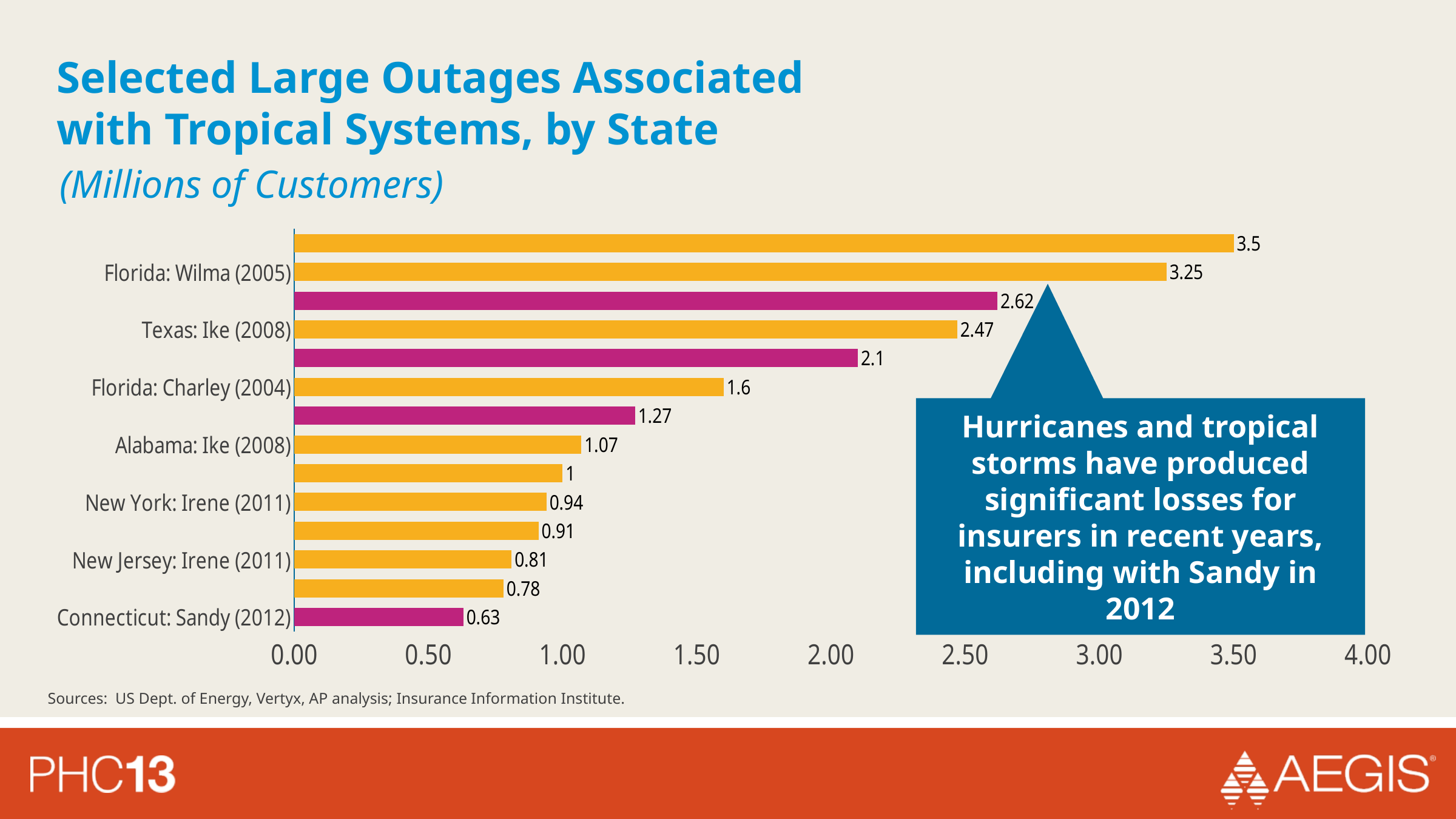
What is the value for Florida: Wilma (2005)? 3.25 What kind of chart is shown on the slide? bar chart Which is larger, the value for Texas: Ike (2008) or Florida: Charley (2004)? Texas: Ike (2008) What is the value for Texas: Ike (2008)? 2.47 What is the difference between the values for Florida: Wilma (2005) and Texas: Ike (2008)? 0.78 What is the largest value shown on any bar in the chart? 3.5 What is the difference between the values for New York: Irene (2011) and New Jersey: Irene (2011)? 0.13 How many bars are plotted in the chart? 14 What is the value for Florida: Charley (2004)? 1.6 What is the value for Connecticut: Sandy (2012)? 0.63 Which labeled category has the lowest value? Connecticut: Sandy (2012) Is the value for Alabama: Ike (2008) greater or less than 1.50? less